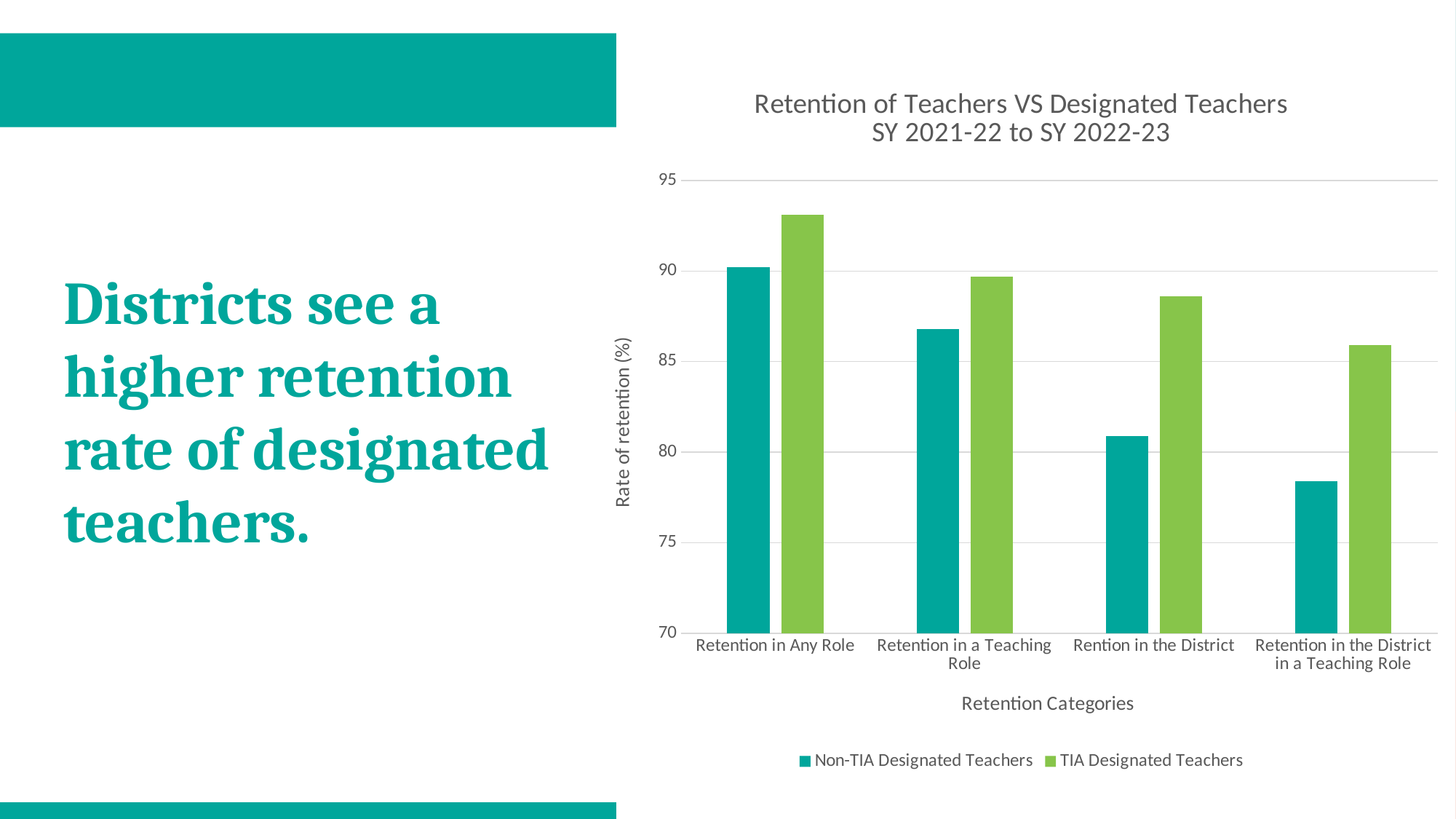
What is the title of the chart? Retention of Teachers VS Designated Teachers SY 2021-22 to SY 2022-23 How many series does the chart's legend list? 2 Is the value for Non-TIA Designated Teachers in Retention in the District in a Teaching Role greater or less than 80? less What is the label of the chart's vertical axis? Rate of retention (%) What kind of chart is shown on the slide? bar chart Which category has the highest bar for TIA Designated Teachers? Retention in Any Role How many retention categories are shown on the x axis of the chart? 4 Is the value for Non-TIA Designated Teachers in Rention in the District greater or less than 85? less Which category has the lowest bar for Non-TIA Designated Teachers? Retention in the District in a Teaching Role Do the values for Non-TIA Designated Teachers rise or fall from left to right across the categories? fall Is the value for TIA Designated Teachers in Retention in Any Role greater or less than 90? greater For Retention in the District in a Teaching Role, which series has the larger value: Non-TIA Designated Teachers or TIA Designated Teachers? TIA Designated Teachers